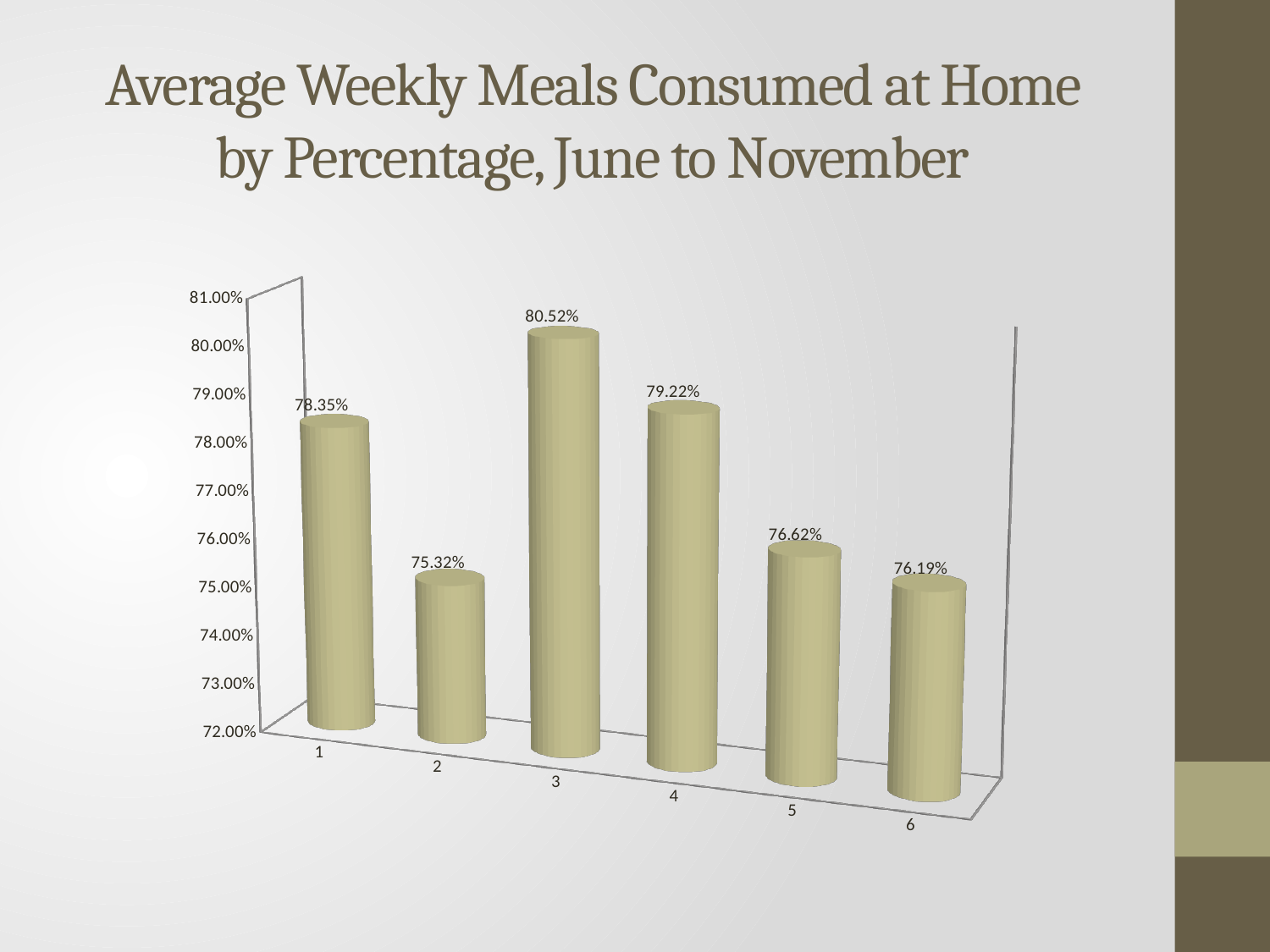
Which category has the highest value? 3 Which category has the lowest value? 2 What is the value for category 3? 80.52% What is the value for category 6? 76.19% What is the title of the chart on the slide? Average Weekly Meals Consumed at Home by Percentage, June to November What is the value for category 1? 78.35% What kind of chart is shown on the slide? bar chart Which is larger, the value for category 1 or the value for category 4? category 4 What is the difference between the values for category 3 and category 2? 5.20% Is the value for category 5 greater or less than 78.00%? less What is the difference between the values for category 4 and category 5? 2.60% How many categories are shown on the chart? 6